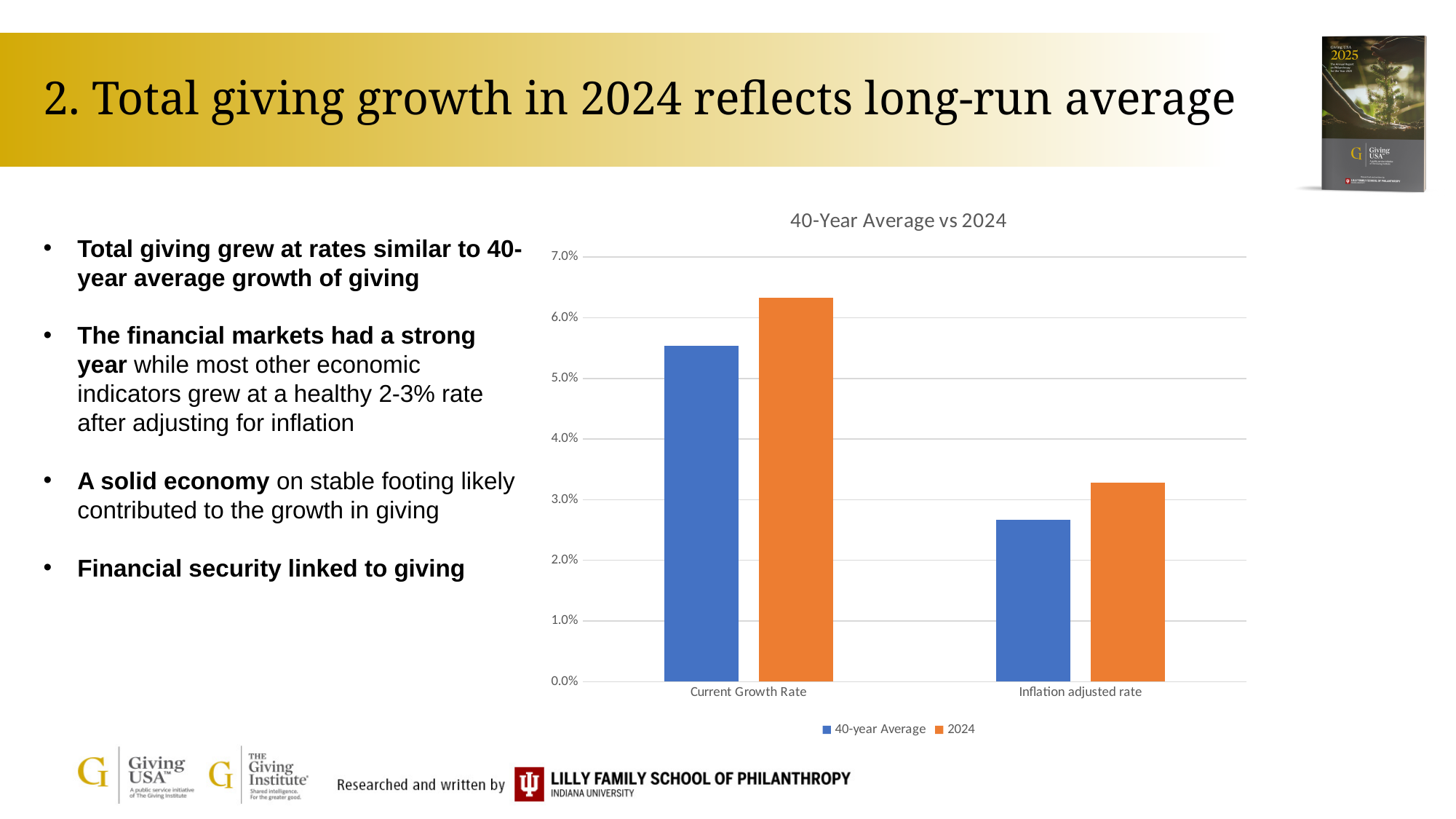
Which bar in the chart is the tallest? 2024 for Current Growth Rate Which series is shown in orange in the chart? 2024 For Current Growth Rate, which is larger: the 40-year Average or 2024? 2024 How many categories are shown on the x axis of the chart? 2 Which bar in the chart is the shortest? 40-year Average for Inflation adjusted rate Is the 40-year Average value for Current Growth Rate greater or less than 6.0%? less How many series does the chart legend list? 2 What is the title of the chart? 40-Year Average vs 2024 Is the 40-year Average value for Inflation adjusted rate greater or less than 3.0%? less Is the 2024 value for Current Growth Rate greater or less than 6.0%? greater What kind of chart is shown on the slide? bar chart